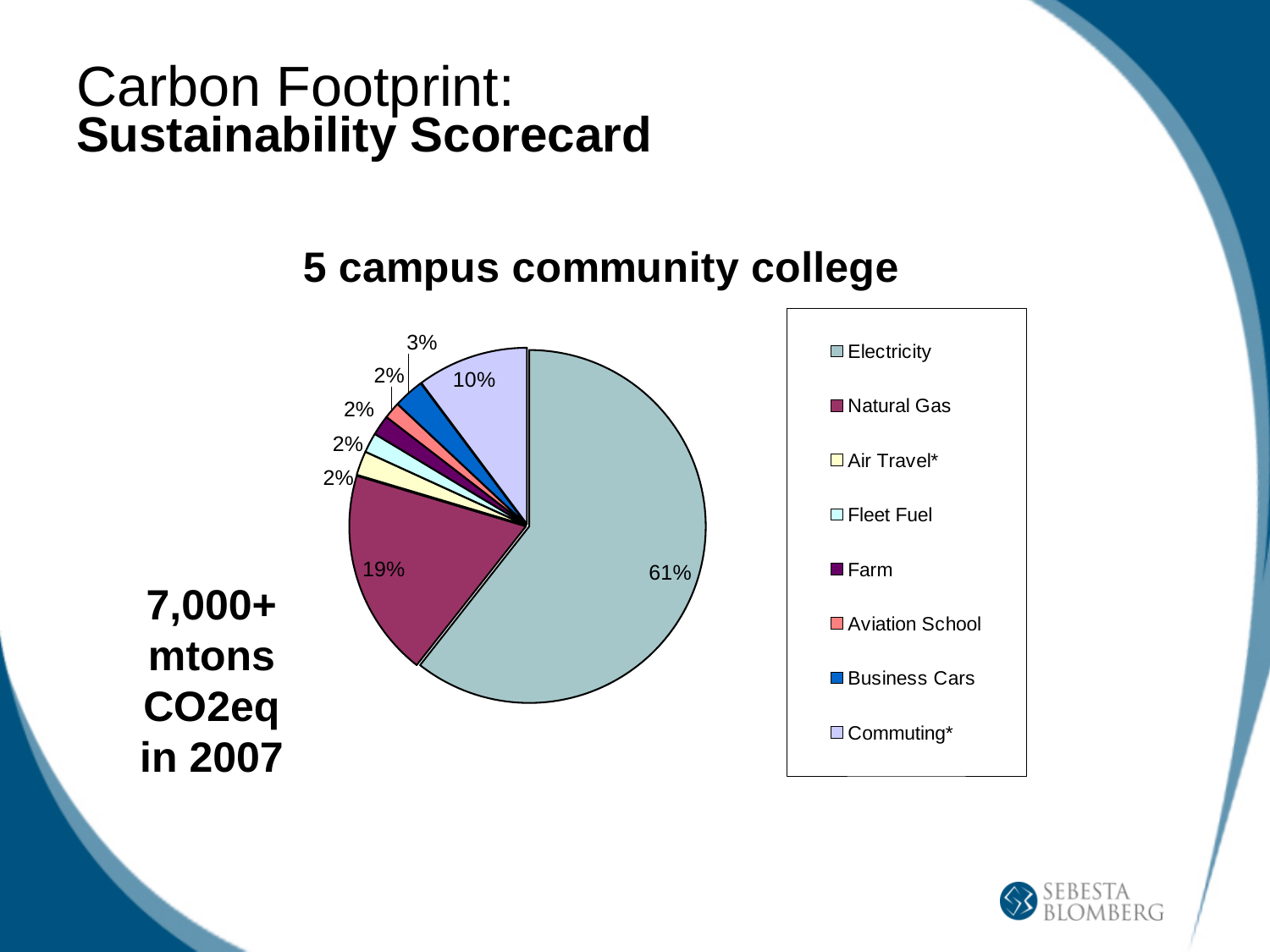
What share of the pie is Commuting*? 10% Which category has the largest slice of the pie? Electricity What percentage does Business Cars represent in the pie chart? 3% What kind of chart is shown on the slide? Pie chart Which is larger, the share for Commuting* or the share for Business Cars? Commuting* What is the title shown above the pie chart? 5 campus community college What share of the pie does Electricity account for? 61% What is the combined share of Electricity and Natural Gas? 80% What is the difference in percentage points between Electricity and Natural Gas? 42 What percentage of the carbon footprint is attributed to Natural Gas? 19% Which legend entry is shown with a maroon colour? Natural Gas How many categories does the legend list? 8